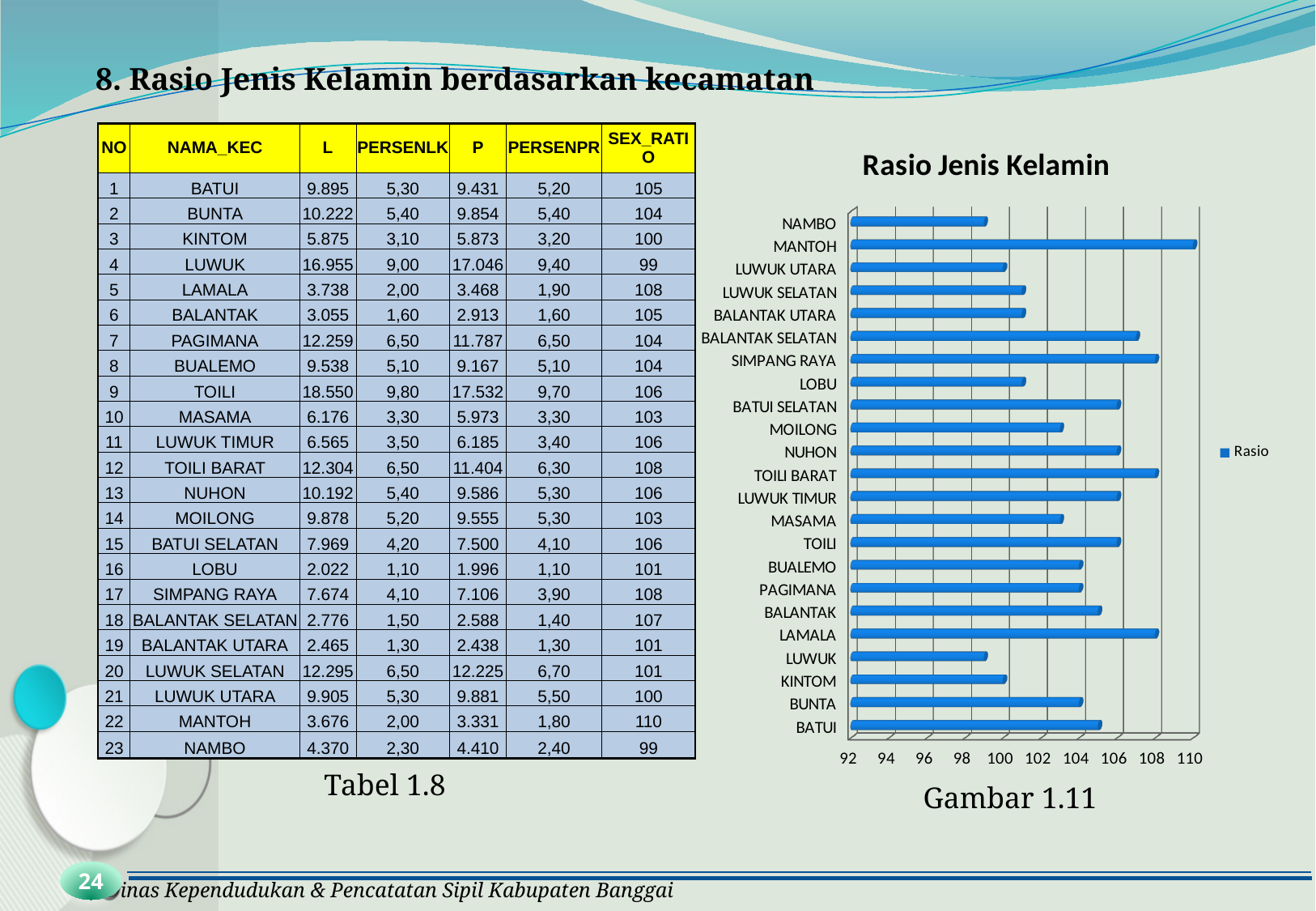
In the "Rasio Jenis Kelamin" chart, what is the value for MANTOH? 110 In the "Rasio Jenis Kelamin" chart, which is larger, the value for MANTOH or the value for NAMBO? MANTOH In the "Rasio Jenis Kelamin" chart, what is the value for LAMALA? 108 In the "Rasio Jenis Kelamin" chart, which is larger, the value for LUWUK or the value for LAMALA? LAMALA How many kecamatan (categories) are plotted in the "Rasio Jenis Kelamin" chart? 23 In the "Rasio Jenis Kelamin" chart, is the value for LOBU greater or less than 104? less How many series does the legend of the "Rasio Jenis Kelamin" chart list? 1 In the "Rasio Jenis Kelamin" chart, what is the value for KINTOM? 100 What kind of chart is shown under the title "Rasio Jenis Kelamin"? bar chart In the "Rasio Jenis Kelamin" chart, which kecamatan has the highest ratio? MANTOH In the "Rasio Jenis Kelamin" chart, is the value for BALANTAK SELATAN greater or less than 104? greater What is the title of the chart on the right side of the slide? Rasio Jenis Kelamin